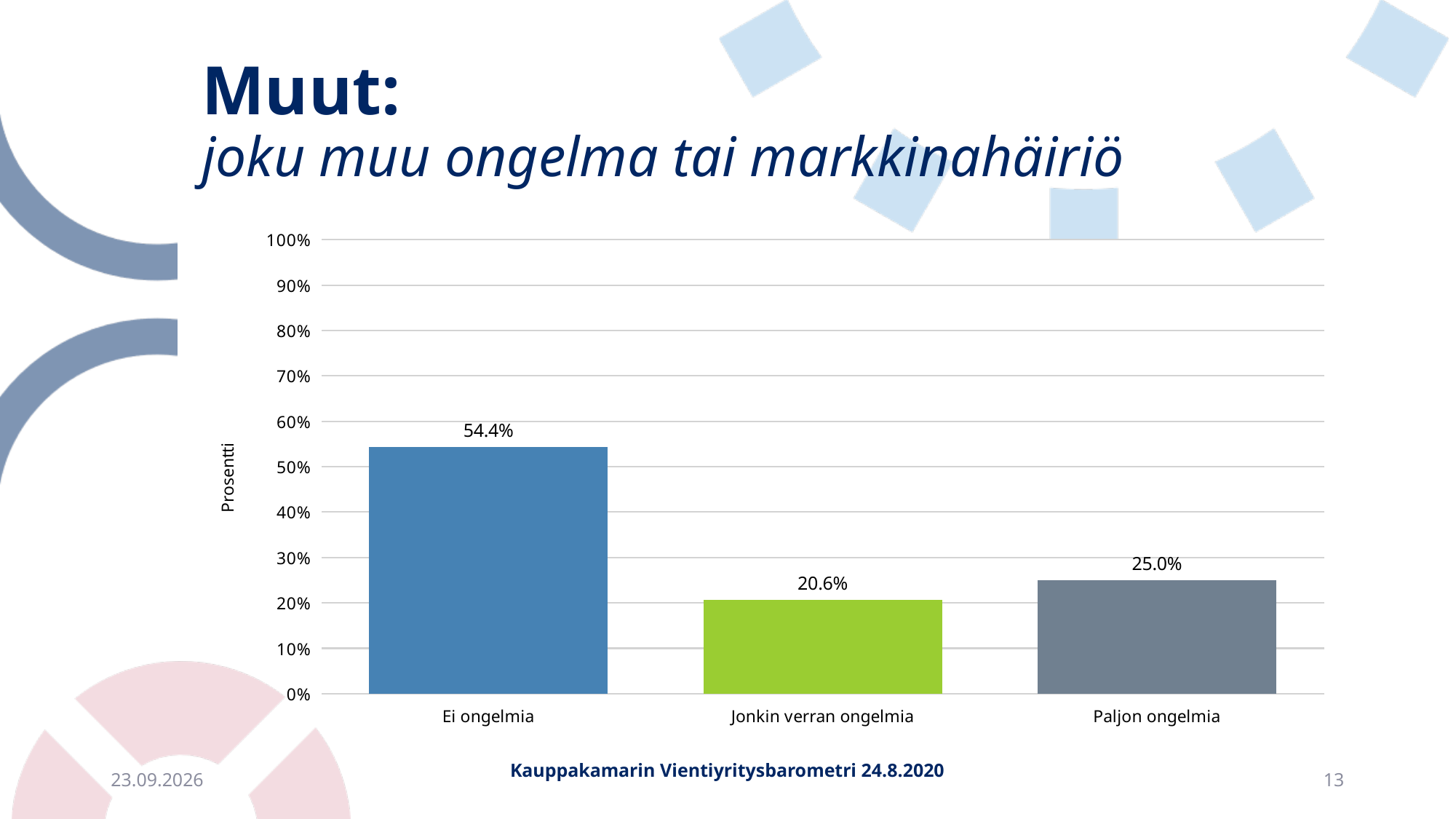
How many categories are shown on the x axis? 3 What kind of chart is shown on the slide? bar chart Which category has the lowest value? Jonkin verran ongelmia What is the value for Ei ongelmia? 54.4% What is the difference between the values for Ei ongelmia and Paljon ongelmia? 29.4% What is the label of the vertical axis? Prosentti Which category has the highest value? Ei ongelmia Which is larger, the value for Jonkin verran ongelmia or the value for Paljon ongelmia? Paljon ongelmia What is the value for Jonkin verran ongelmia? 20.6% What is the value for Paljon ongelmia? 25.0% Is the value for Ei ongelmia greater or less than 50%? greater What is the difference between the values for Paljon ongelmia and Jonkin verran ongelmia? 4.4%